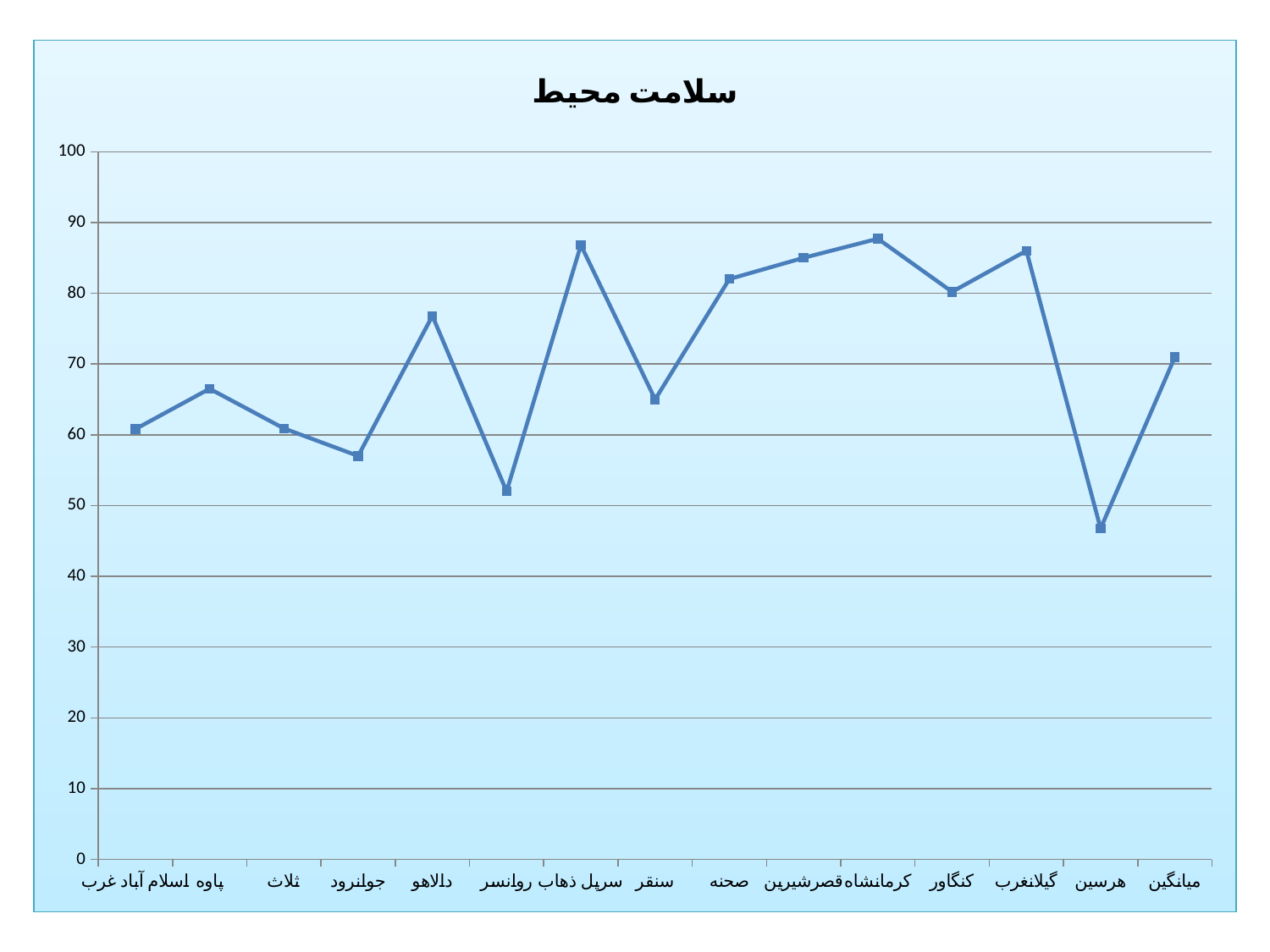
How many categories are plotted along the x axis? 15 Which has the larger value, پاوه or جوانرود? پاوه Which has the larger value, دالاهو or روانسر? دالاهو Is the value for روانسر greater or less than 60? less Which category has the lowest value? هرسین What kind of chart is shown on the slide? line chart Is the value for هرسین greater or less than 50? less What is the title of the chart? سلامت محیط Is the value for جوانرود greater or less than 60? less